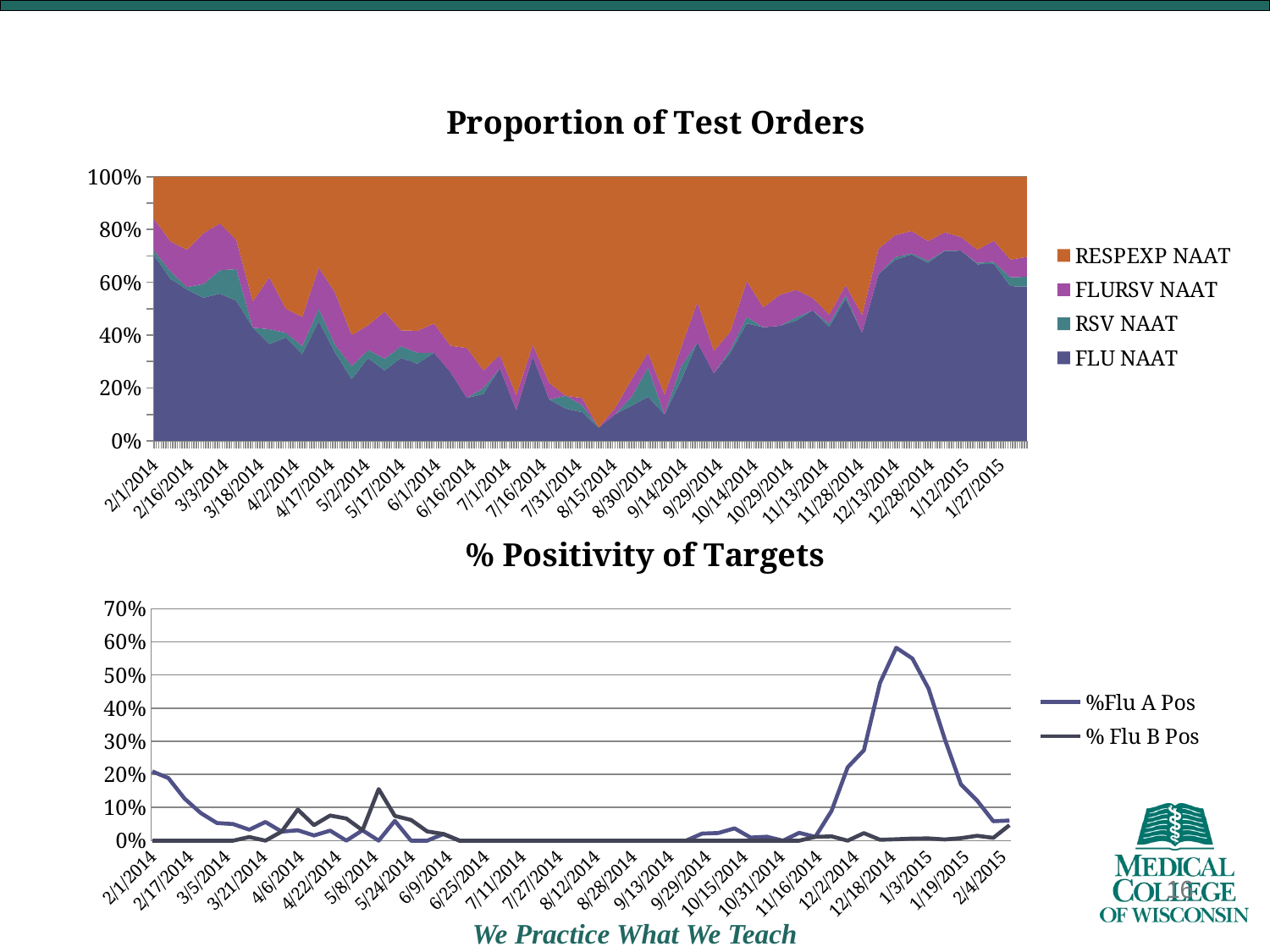
In the 'Proportion of Test Orders' chart, is the FLU NAAT share at 2/1/2014 greater or less than 40%? greater How many series does the legend of the 'Proportion of Test Orders' chart list? 4 In the '% Positivity of Targets' chart, does %Flu A Pos rise or fall between 12/2/2014 and 1/3/2015? rise In the '% Positivity of Targets' chart, what are the two series named in the legend? %Flu A Pos and % Flu B Pos In the '% Positivity of Targets' chart, which series reaches the higher peak, %Flu A Pos or % Flu B Pos? %Flu A Pos What kind of chart is the '% Positivity of Targets' chart? line chart In the 'Proportion of Test Orders' chart, which series makes up the largest share of test orders around 8/15/2014? RESPEXP NAAT What kind of chart is the 'Proportion of Test Orders' chart? stacked area chart In the 'Proportion of Test Orders' chart, which series is shown in orange? RESPEXP NAAT How many series does the legend of the '% Positivity of Targets' chart list? 2 In the '% Positivity of Targets' chart, is the peak value of %Flu A Pos greater or less than 50%? greater In the 'Proportion of Test Orders' chart, is the FLU NAAT share at 8/15/2014 greater or less than 20%? less